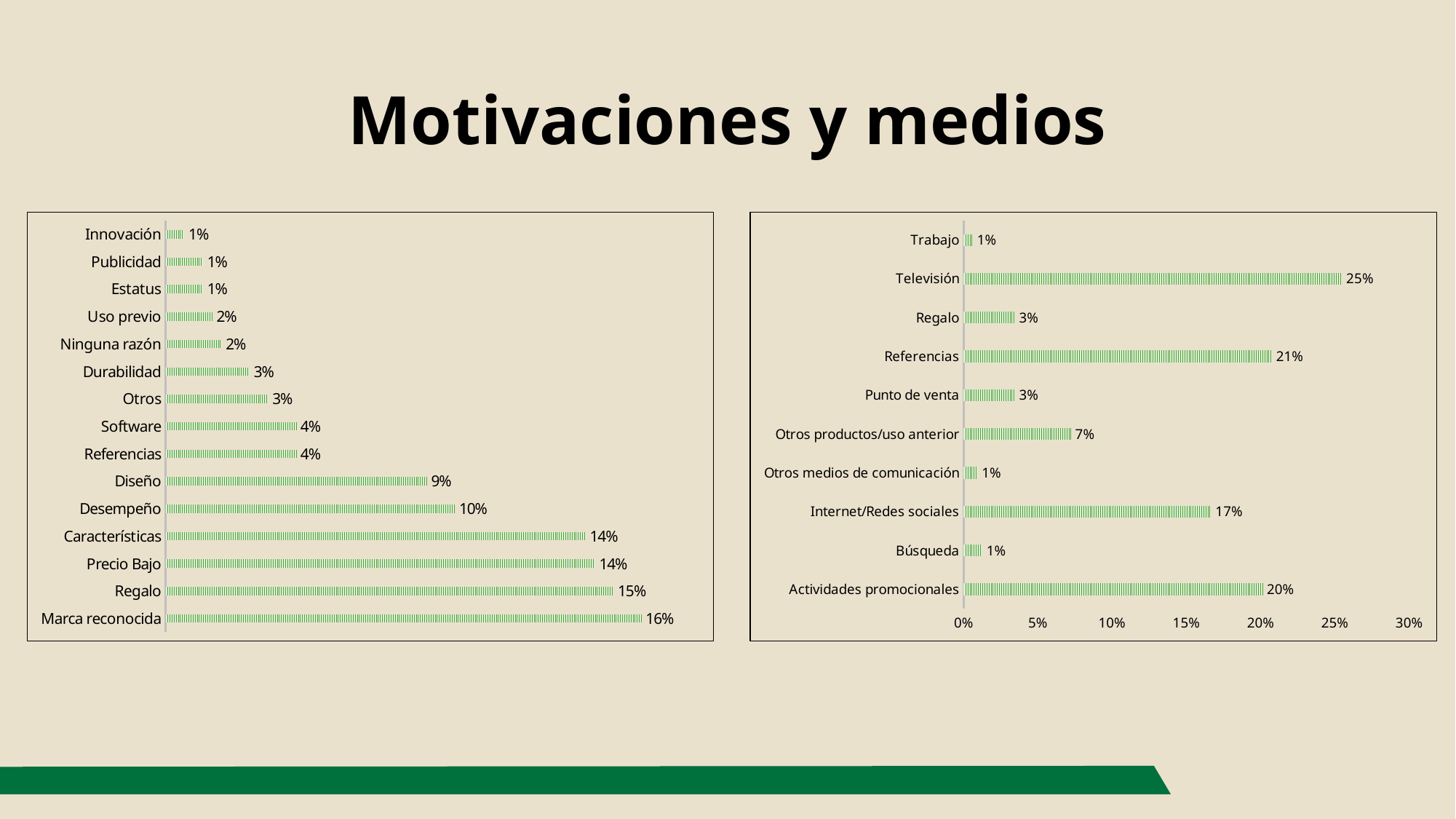
In the right chart, what is the value for Referencias? 21% In the left chart, what is the value for Desempeño? 10% In the left chart, what is the difference between Regalo and Diseño? 6% How many categories are shown in the left chart? 15 What type of chart is the right chart? Bar chart In the right chart, what is the value for Otros productos/uso anterior? 7% In the right chart, which is larger, Internet/Redes sociales or Referencias? Referencias In the right chart, which category has the highest value? Televisión How many categories are shown in the right chart? 10 In the left chart, which category has the highest value? Marca reconocida In the left chart, what is the value for Marca reconocida? 16% In the right chart, what is the difference between Televisión and Actividades promocionales? 5%